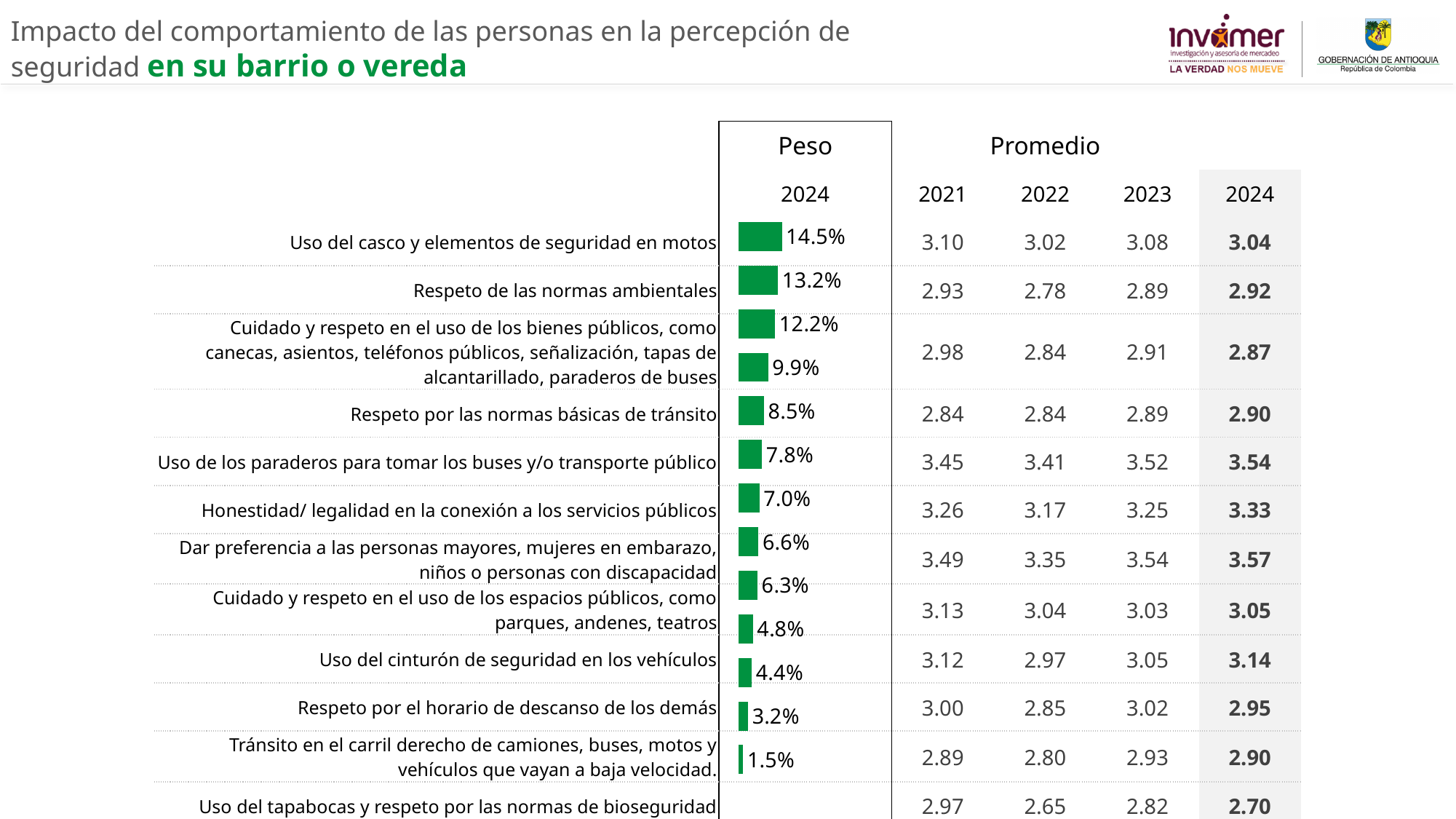
Do the bar values in the 'Peso 2024' chart increase or decrease from top to bottom? decrease In the 'Peso 2024' bar chart, what is the difference between the two longest bars, 14.5% and 13.2%? 1.3 percentage points In the 'Peso 2024' bar chart, what value is shown for 'Uso del casco y elementos de seguridad en motos'? 14.5% What is the heading above the bar chart column? Peso What type of chart is shown under the 'Peso' heading? bar chart What is the highest value shown in the 'Peso 2024' bar chart? 14.5% In the 'Peso 2024' bar chart, which is larger: the bar labelled 9.9% or the bar labelled 8.5%? 9.9% What is the lowest value shown in the 'Peso 2024' bar chart? 1.5% In the 'Peso 2024' bar chart, what is the difference between the highest value (14.5%) and the lowest value (1.5%)? 13.0 percentage points How many bars are plotted in the 'Peso 2024' bar chart? 13 In the 'Peso 2024' bar chart, which is larger: the bar labelled 4.4% or the bar labelled 6.3%? 6.3% What colour are the bars in the 'Peso 2024' chart? green